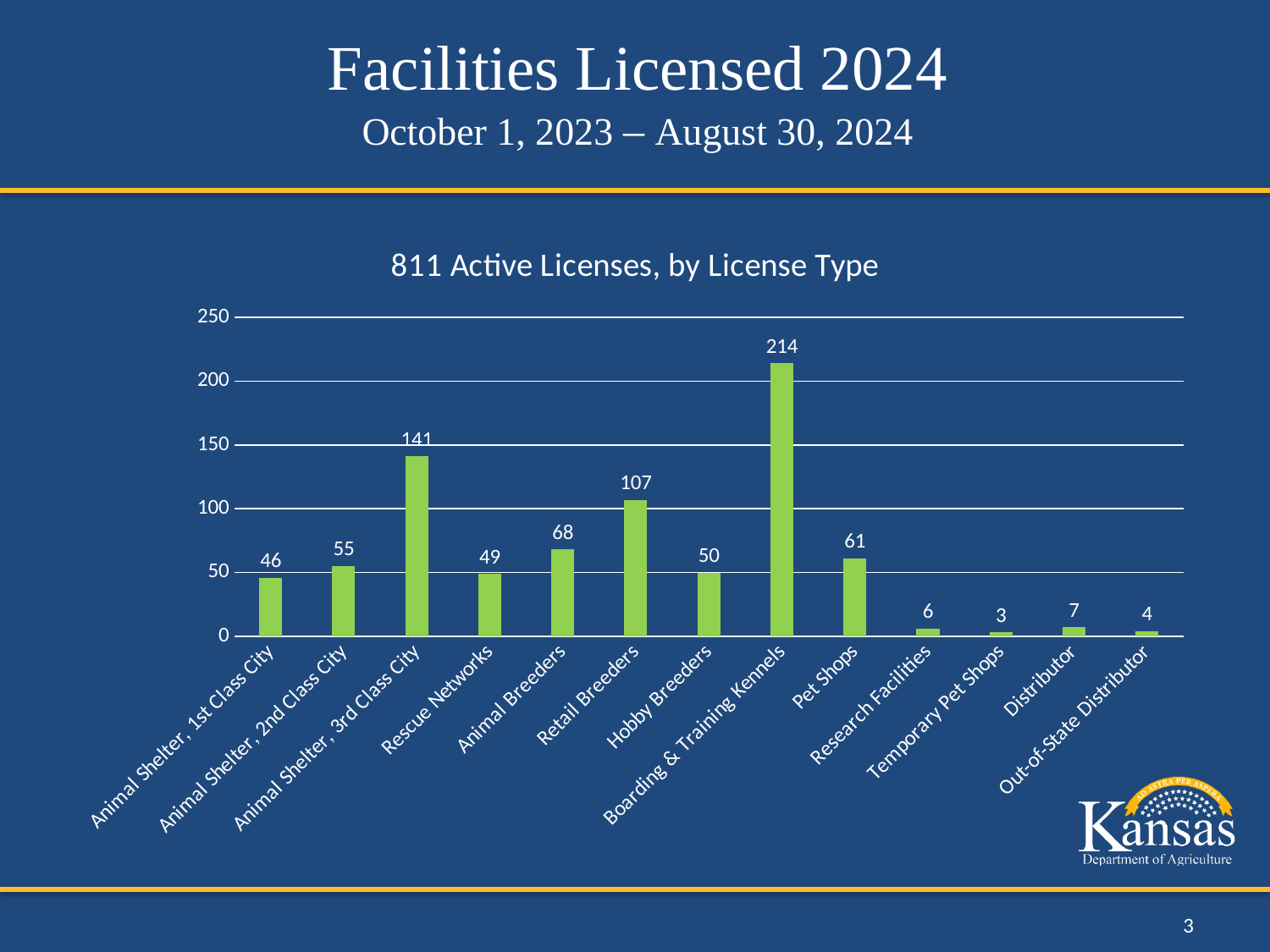
What is the title of the chart? 811 Active Licenses, by License Type What is the value for Retail Breeders? 107 Which is larger, the value for Pet Shops or the value for Animal Breeders? Animal Breeders Is the value for Retail Breeders greater or less than 100? greater What is the value for Boarding & Training Kennels? 214 What kind of chart is shown on the slide? Bar chart What is the value for Animal Shelter, 3rd Class City? 141 How many license types are shown on the chart? 13 What is the value for Temporary Pet Shops? 3 Which license type has the highest number of active licenses? Boarding & Training Kennels Which license type has the lowest number of active licenses? Temporary Pet Shops What is the difference between the values for Boarding & Training Kennels and Animal Shelter, 3rd Class City? 73